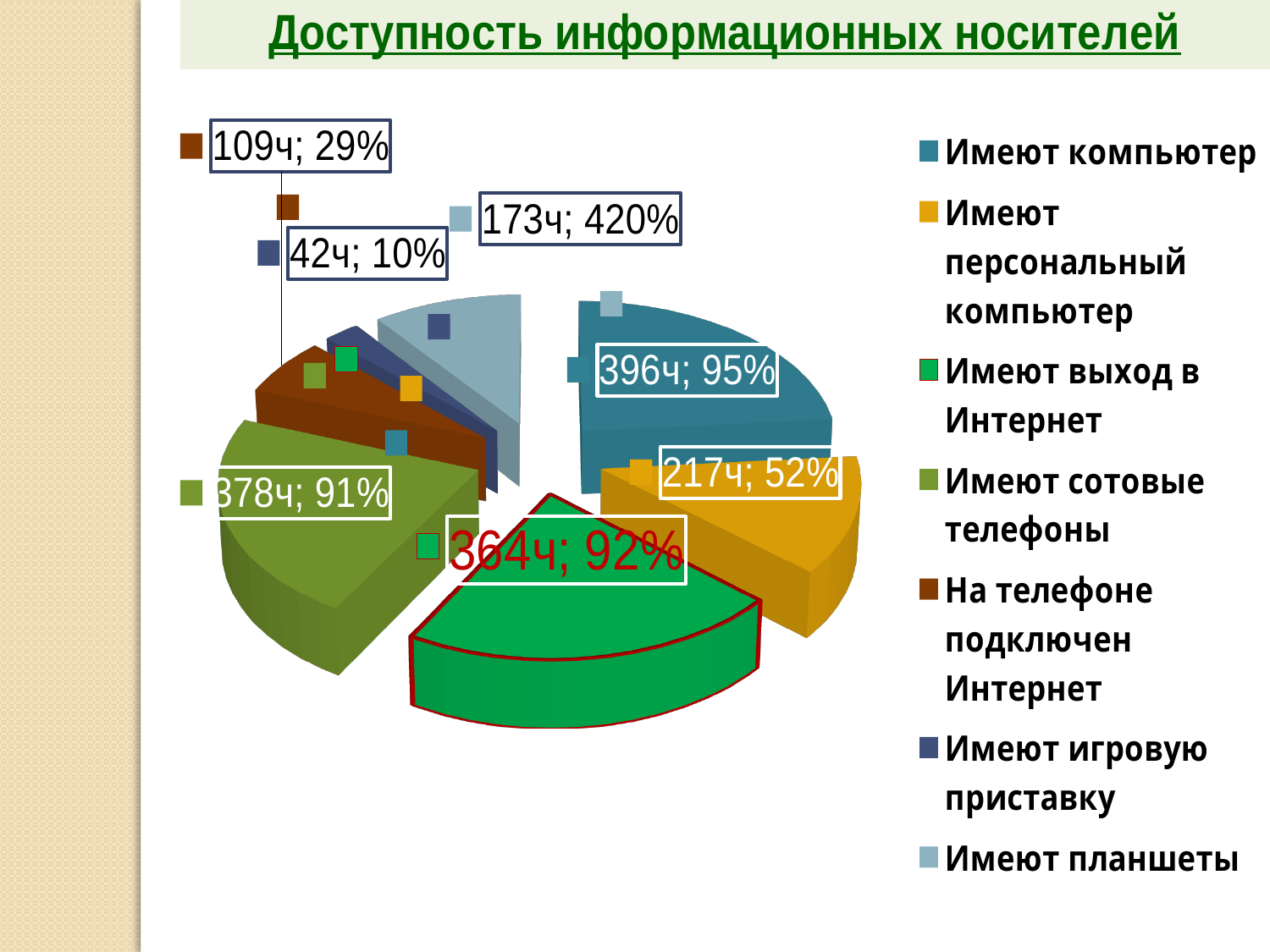
What is the title of the slide? Доступность информационных носителей What is the difference in people between 'Имеют выход в Интернет' (364ч) and 'Имеют персональный компьютер' (217ч)? 147ч Which category has the highest count of people (ч)? Имеют компьютер What is the difference in people between 'Имеют компьютер' (396ч) and 'Имеют сотовые телефоны' (378ч)? 18ч What is the data label shown for the 'На телефоне подключен Интернет' slice? 109ч; 29% What is the data label shown for the 'Имеют планшеты' slice? 173ч; 420% What kind of chart is shown on the slide? Pie chart What is the data label shown for the 'Имеют компьютер' slice? 396ч; 95% What is the data label shown for the 'Имеют игровую приставку' slice? 42ч; 10% Which is larger: the count for 'Имеют сотовые телефоны' or for 'Имеют выход в Интернет'? Имеют сотовые телефоны Which category has the lowest count of people (ч)? Имеют игровую приставку How many categories does the legend list? 7